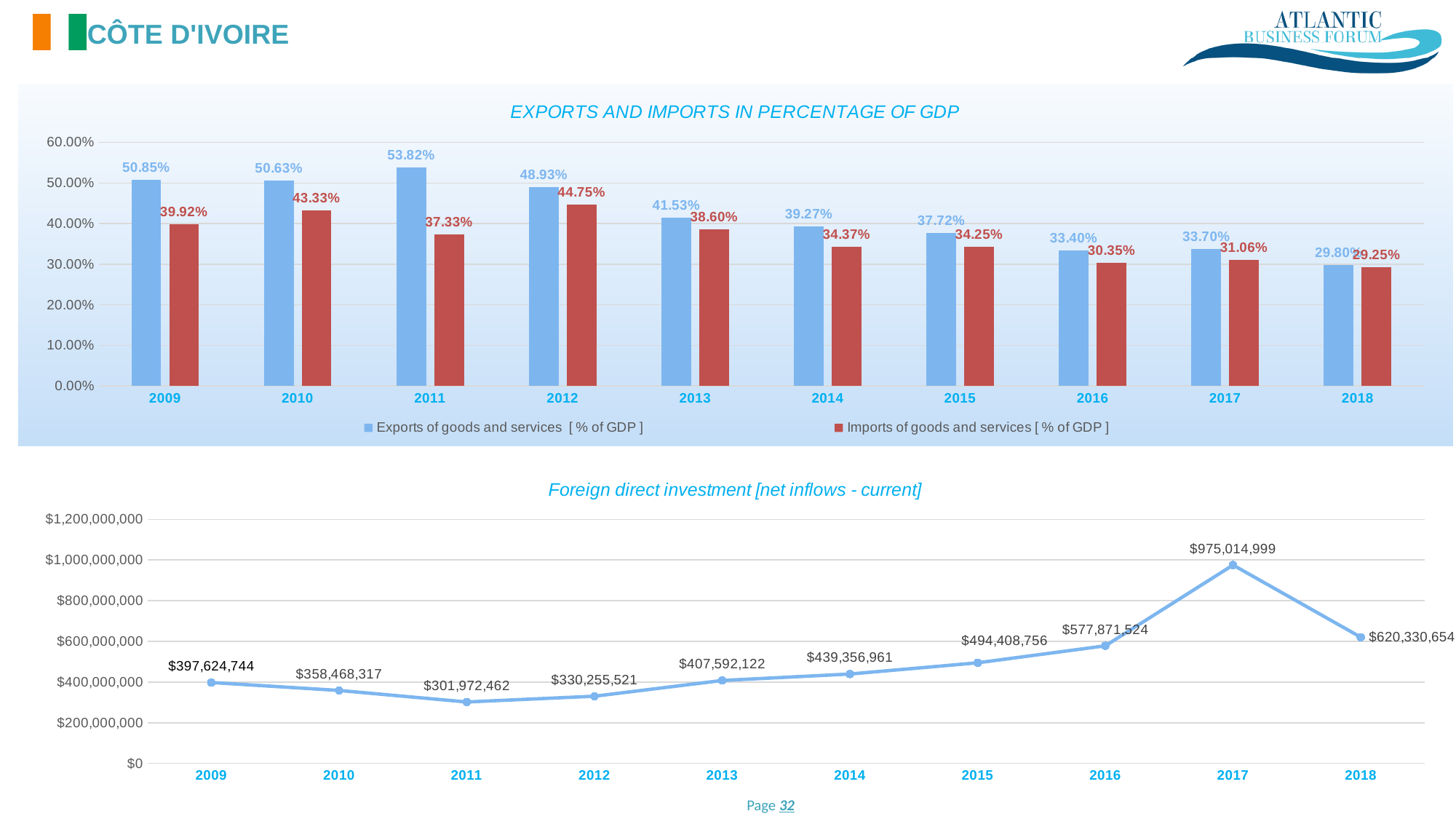
In the 'EXPORTS AND IMPORTS IN PERCENTAGE OF GDP' chart, what is the overall trend of exports from 2009 to 2018? Falling In the 'Foreign direct investment [net inflows - current]' chart, which year has the lowest value? 2011 In the 'Foreign direct investment [net inflows - current]' chart, how many years are plotted? 10 In the 'EXPORTS AND IMPORTS IN PERCENTAGE OF GDP' chart, how many series does the legend list? 2 What kind of chart is the 'Foreign direct investment [net inflows - current]' chart? Line chart In the 'Foreign direct investment [net inflows - current]' chart, what is the value for 2017? $975,014,999 In the 'EXPORTS AND IMPORTS IN PERCENTAGE OF GDP' chart, what is the difference between exports and imports in 2009? 10.93% In the 'EXPORTS AND IMPORTS IN PERCENTAGE OF GDP' chart, what is the value of exports of goods and services in 2011? 53.82% In the 'EXPORTS AND IMPORTS IN PERCENTAGE OF GDP' chart, what is the value of imports of goods and services in 2012? 44.75% In the 'EXPORTS AND IMPORTS IN PERCENTAGE OF GDP' chart, which year has the lowest imports value? 2018 In the 'Foreign direct investment [net inflows - current]' chart, which is larger: the value for 2016 or the value for 2018? 2018 In the 'EXPORTS AND IMPORTS IN PERCENTAGE OF GDP' chart, which year has the highest exports value? 2011